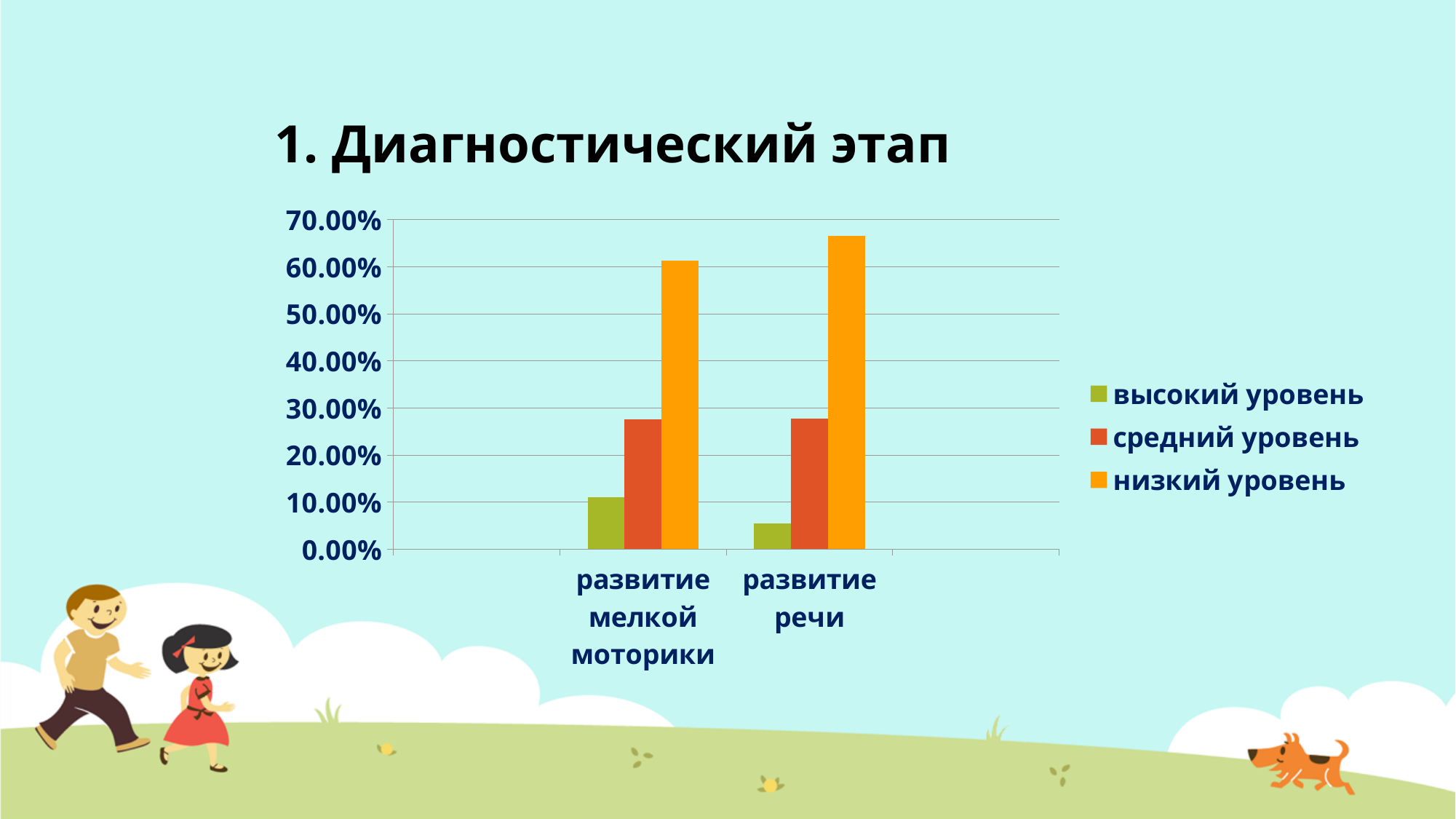
Is the value of высокий уровень for развитие мелкой моторики greater or less than 20.00%? less Is the value of высокий уровень for развитие речи greater or less than 10.00%? less Which category has the larger value for высокий уровень: развитие мелкой моторики or развитие речи? развитие мелкой моторики Is the value of низкий уровень for развитие мелкой моторики greater or less than 50.00%? greater Which series has the highest value for развитие речи? низкий уровень How many series does the legend list? 3 How many categories are shown on the x axis? 2 Which category has the larger value for низкий уровень: развитие мелкой моторики or развитие речи? развитие речи What kind of chart is shown on the slide? bar chart Which series has the lowest value for развитие мелкой моторики? высокий уровень